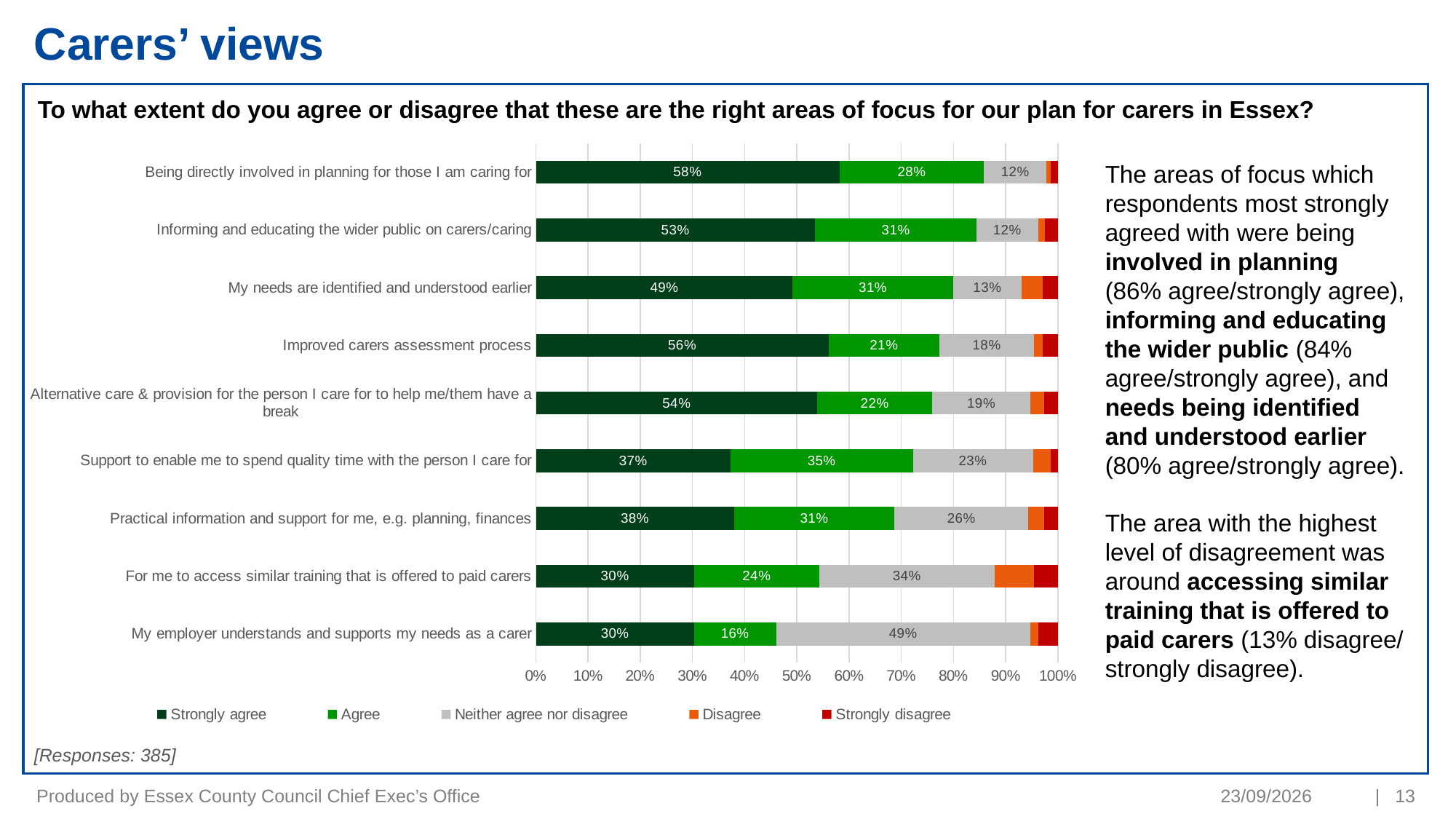
Which has a higher "Strongly agree" percentage: "Informing and educating the wider public on carers/caring" or "My needs are identified and understood earlier"? Informing and educating the wider public on carers/caring Which area of focus has the lowest "Agree" percentage? My employer understands and supports my needs as a carer Which area of focus has the highest "Neither agree nor disagree" percentage? My employer understands and supports my needs as a carer What type of chart is shown on the slide? Stacked bar chart How many areas of focus are shown in the chart? 9 What is the combined "Strongly agree" and "Agree" percentage for "Being directly involved in planning for those I am caring for"? 86% Which area of focus has the highest "Strongly agree" percentage? Being directly involved in planning for those I am caring for How many response categories does the legend list? 5 What percentage of respondents strongly agree with "Being directly involved in planning for those I am caring for"? 58% What is the difference in the "Agree" percentage between "Support to enable me to spend quality time with the person I care for" and "Practical information and support for me, e.g. planning, finances"? 4 percentage points What percentage of respondents agree with "My employer understands and supports my needs as a carer"? 16% What percentage of respondents neither agree nor disagree with "For me to access similar training that is offered to paid carers"? 34%